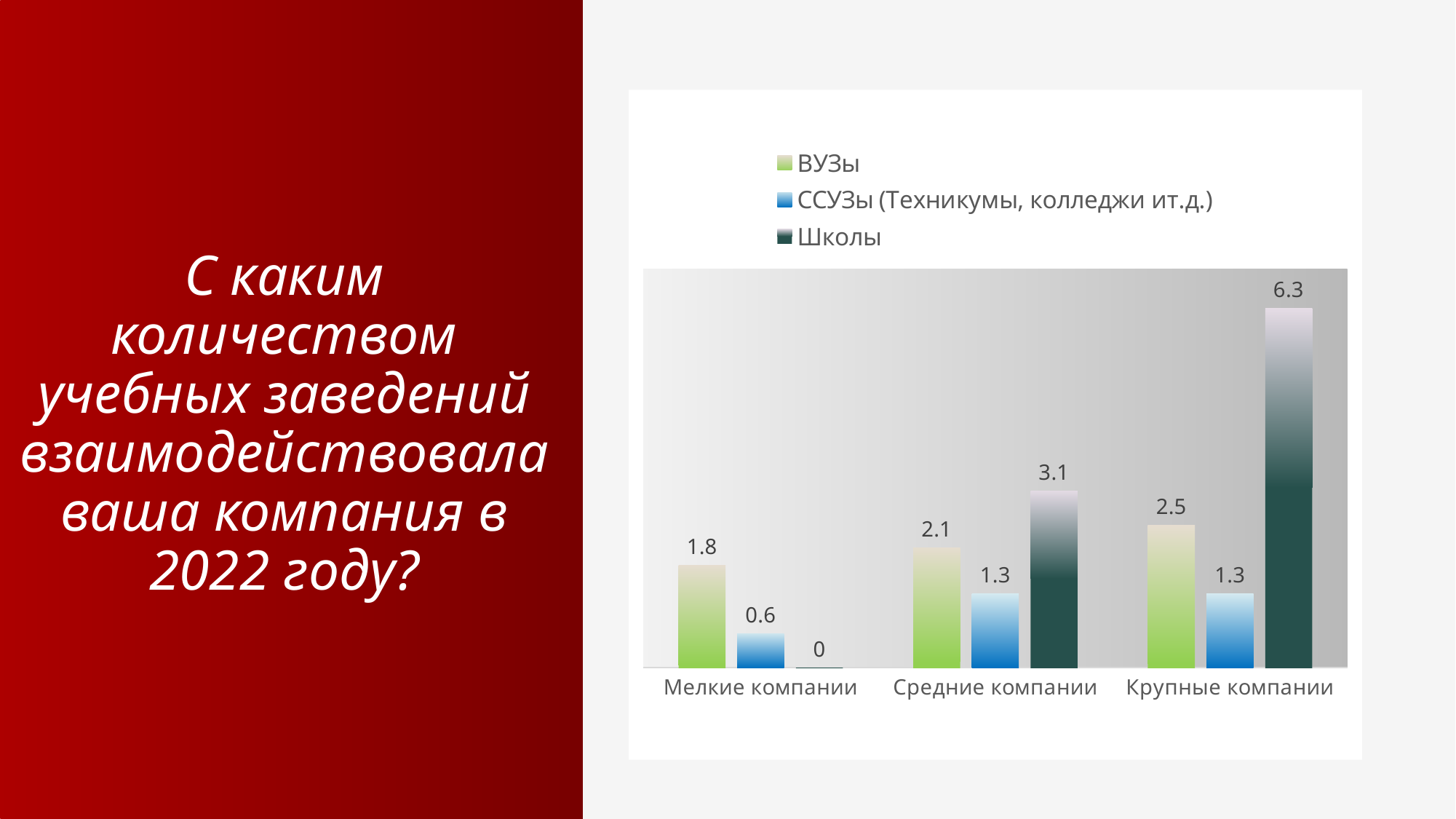
Which category has the lowest value for ССУЗы (Техникумы, колледжи ит.д.)? Мелкие компании How many series does the legend list? 3 What is the value for ВУЗы in the Мелкие компании category? 1.8 What is the value for Школы in the Мелкие компании category? 0 What is the value for ССУЗы (Техникумы, колледжи ит.д.) in the Средние компании category? 1.3 Do the ВУЗы values rise or fall from Мелкие компании to Крупные компании? Rise What is the value for Школы in the Крупные компании category? 6.3 Which is larger in the Средние компании category: ВУЗы or Школы? Школы Which category has the highest value for Школы? Крупные компании What is the difference between the Школы values for Крупные компании and Средние компании? 3.2 How many categories are shown on the x axis? 3 What kind of chart is shown on the slide? Bar chart